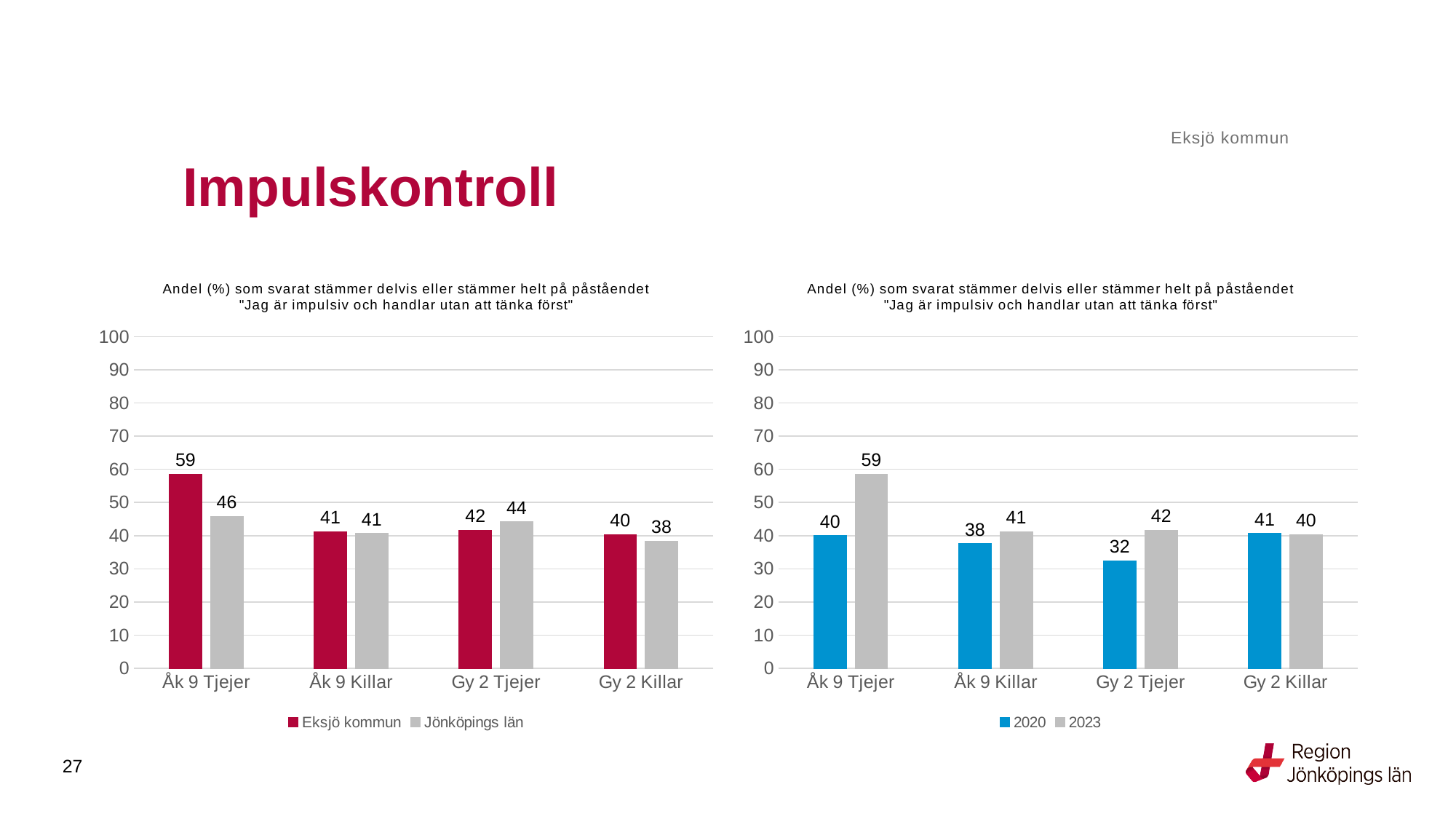
In the right chart, what is the 2023 value for Åk 9 Killar? 41 In the right chart, which category has the lowest 2020 value? Gy 2 Tjejer In the left chart, which category has the highest Eksjö kommun value? Åk 9 Tjejer In the left chart, which is larger for Gy 2 Tjejer: Eksjö kommun or Jönköpings län? Jönköpings län In the right chart, how many categories are shown on the x axis? 4 In the left chart, how many series does the legend list? 2 In the right chart, what is the 2020 value for Gy 2 Tjejer? 32 In the left chart, what is the value for Jönköpings län for Gy 2 Killar? 38 In the left chart, what is the difference between Eksjö kommun and Jönköpings län for Åk 9 Tjejer? 13 What kind of chart is the right chart? Bar chart In the left chart, what is the value for Eksjö kommun for Åk 9 Tjejer? 59 In the right chart, what is the difference between the 2023 and 2020 values for Åk 9 Tjejer? 19